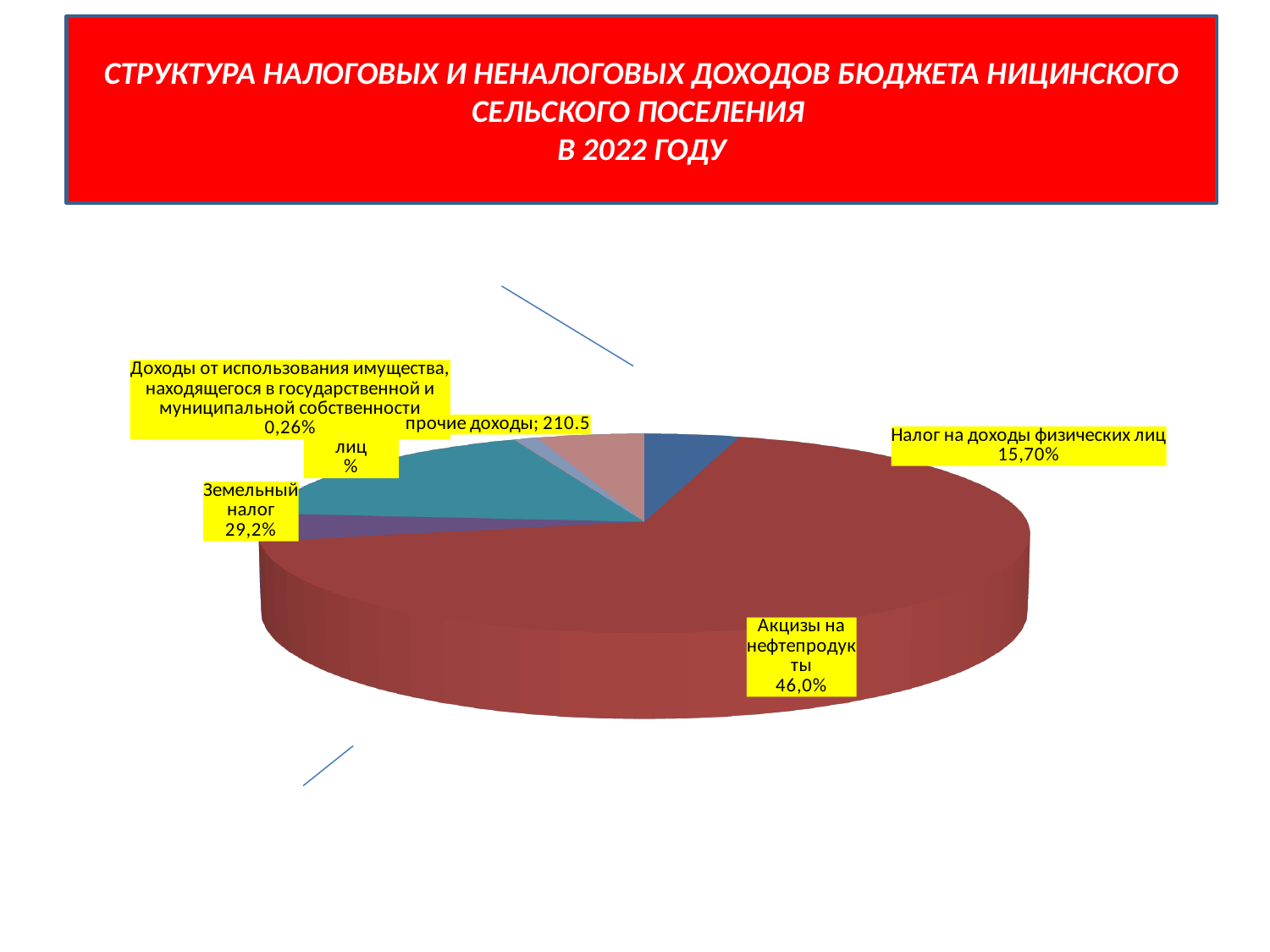
By how many percentage points does the share for Земельный налог exceed the share for Налог на доходы физических лиц? 13,5% Which is larger: the share for Земельный налог or the share for Налог на доходы физических лиц? Земельный налог What year does the chart title say the budget income structure refers to? 2022 Which category has the largest share of the pie? Акцизы на нефтепродукты What share is shown for Налог на доходы физических лиц? 15,70% By how many percentage points does the share for Акцизы на нефтепродукты exceed the share for Земельный налог? 16,8% What value is printed in the label for прочие доходы? 210.5 What share is shown for Доходы от использования имущества, находящегося в государственной и муниципальной собственности? 0,26% What share is shown for Акцизы на нефтепродукты? 46,0% What share is shown for Земельный налог? 29,2% What kind of chart is shown on the slide? Pie chart Which category has the smallest percentage share shown on the chart? Доходы от использования имущества, находящегося в государственной и муниципальной собственности